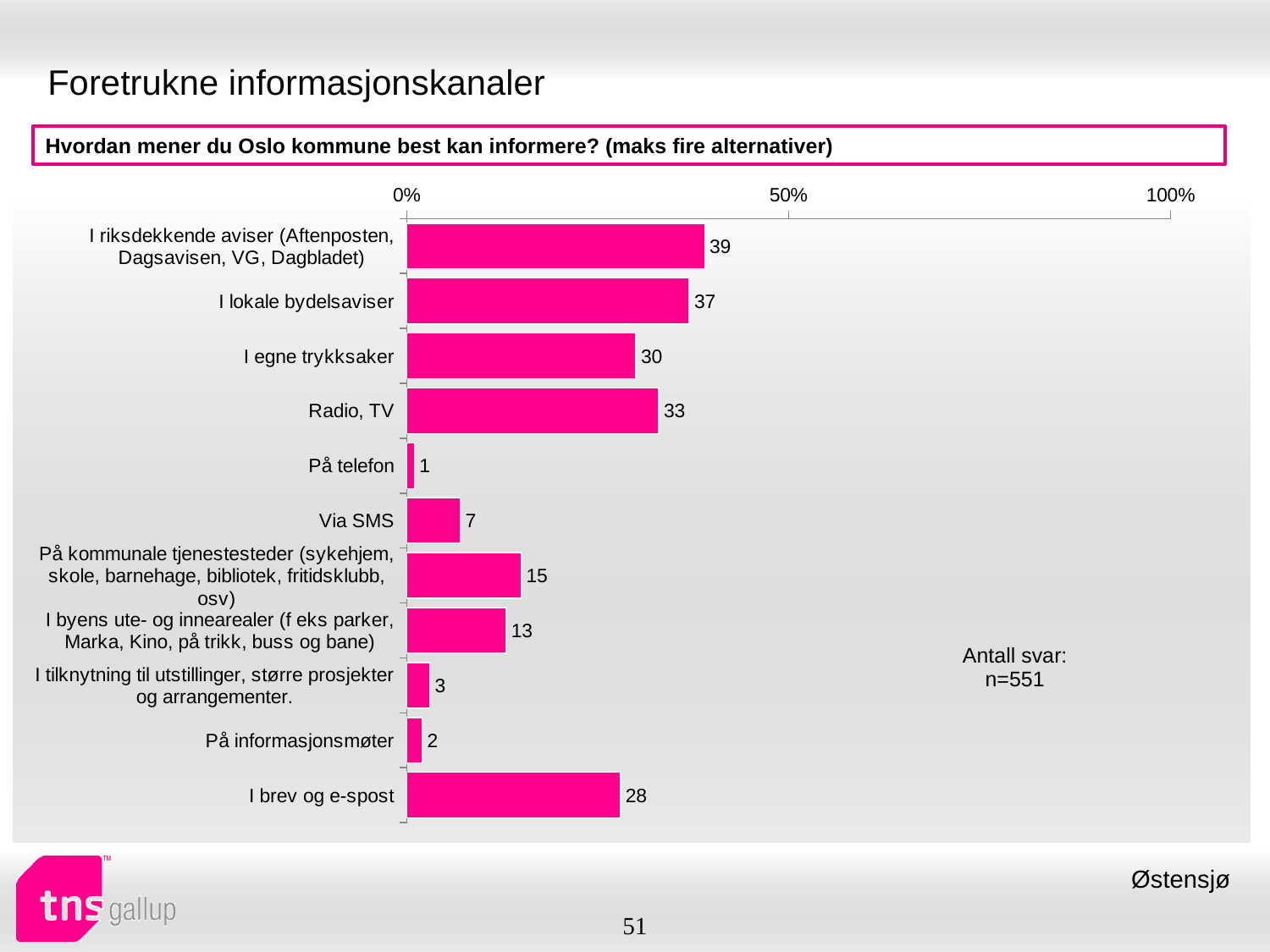
Which is larger, the value for 'Via SMS' or the value for 'På kommunale tjenestesteder'? På kommunale tjenestesteder What is the title of the slide? Foretrukne informasjonskanaler Which category has the highest value? I riksdekkende aviser (Aftenposten, Dagsavisen, VG, Dagbladet) How many categories are shown in the chart? 11 Is the value for 'I riksdekkende aviser' greater or less than 50%? less What is the value for 'Radio, TV'? 33 What is the number of responses (n) stated on the slide? n=551 What is the value for 'I brev og e-spost'? 28 What is the value for 'I lokale bydelsaviser'? 37 What is the difference between the values for 'I riksdekkende aviser' and 'I egne trykksaker'? 9 Which category has the lowest value? På telefon What kind of chart is shown on the slide? bar chart